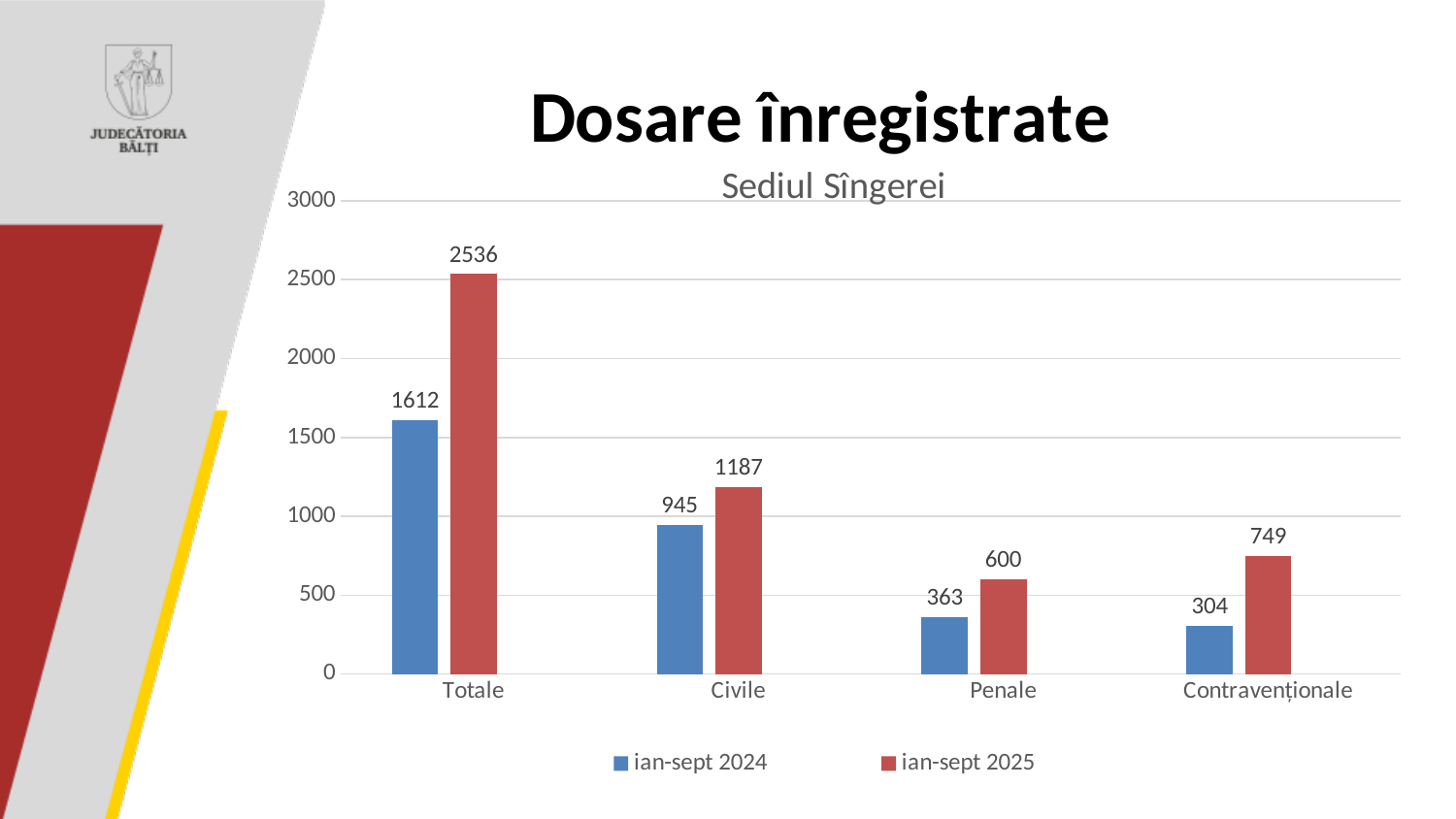
What is the value for Totale in the ian-sept 2025 series? 2536 How many categories are shown on the x axis? 4 Which category has the highest value in the ian-sept 2025 series? Totale What kind of chart is shown on the slide? bar chart Which is larger for Penale: the ian-sept 2024 value or the ian-sept 2025 value? ian-sept 2025 What is the difference between the ian-sept 2025 and ian-sept 2024 values for Totale? 924 Which category has the lowest value in the ian-sept 2024 series? Contravenționale What is the value for Civile in the ian-sept 2024 series? 945 What is the value for Contravenționale in the ian-sept 2024 series? 304 What is the value for Penale in the ian-sept 2025 series? 600 Is the ian-sept 2025 value for Civile greater or less than 1000? greater How many series does the legend list? 2